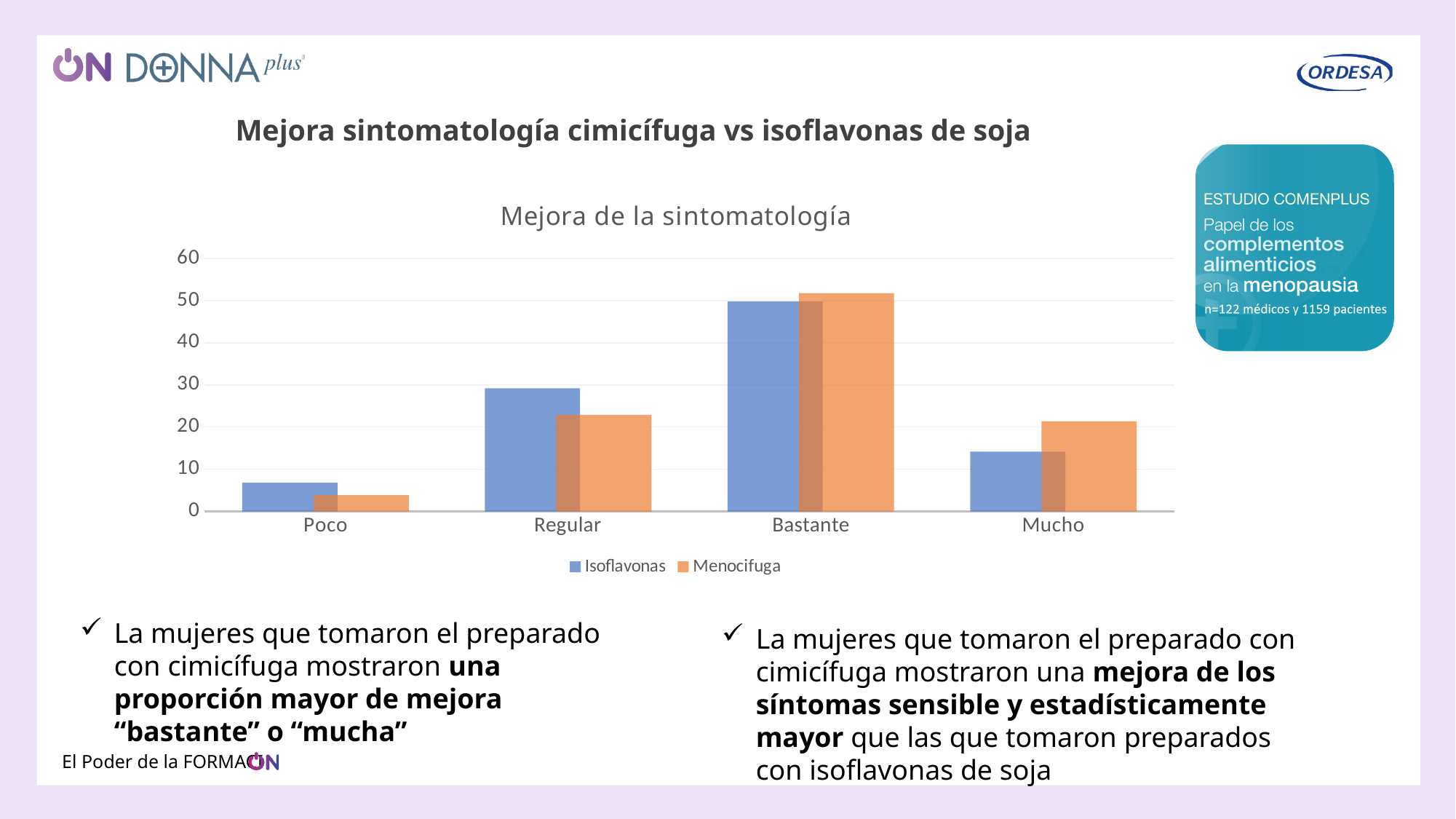
How many categories are shown on the x axis? 4 Which category has the highest value for the Menocifuga series? Bastante In the Mucho category, which series has the larger value, Isoflavonas or Menocifuga? Menocifuga What kind of chart is shown on the slide? bar chart Which category has the lowest value for the Isoflavonas series? Poco What is the title of the chart? Mejora de la sintomatología Is the value for Isoflavonas in the Regular category greater or less than 20? greater Which category has the lowest value for the Menocifuga series? Poco Is the value for Menocifuga in the Mucho category greater or less than 20? greater In the Regular category, which series has the larger value, Isoflavonas or Menocifuga? Isoflavonas How many series does the legend list? 2 Is the value for Menocifuga in the Poco category greater or less than 10? less